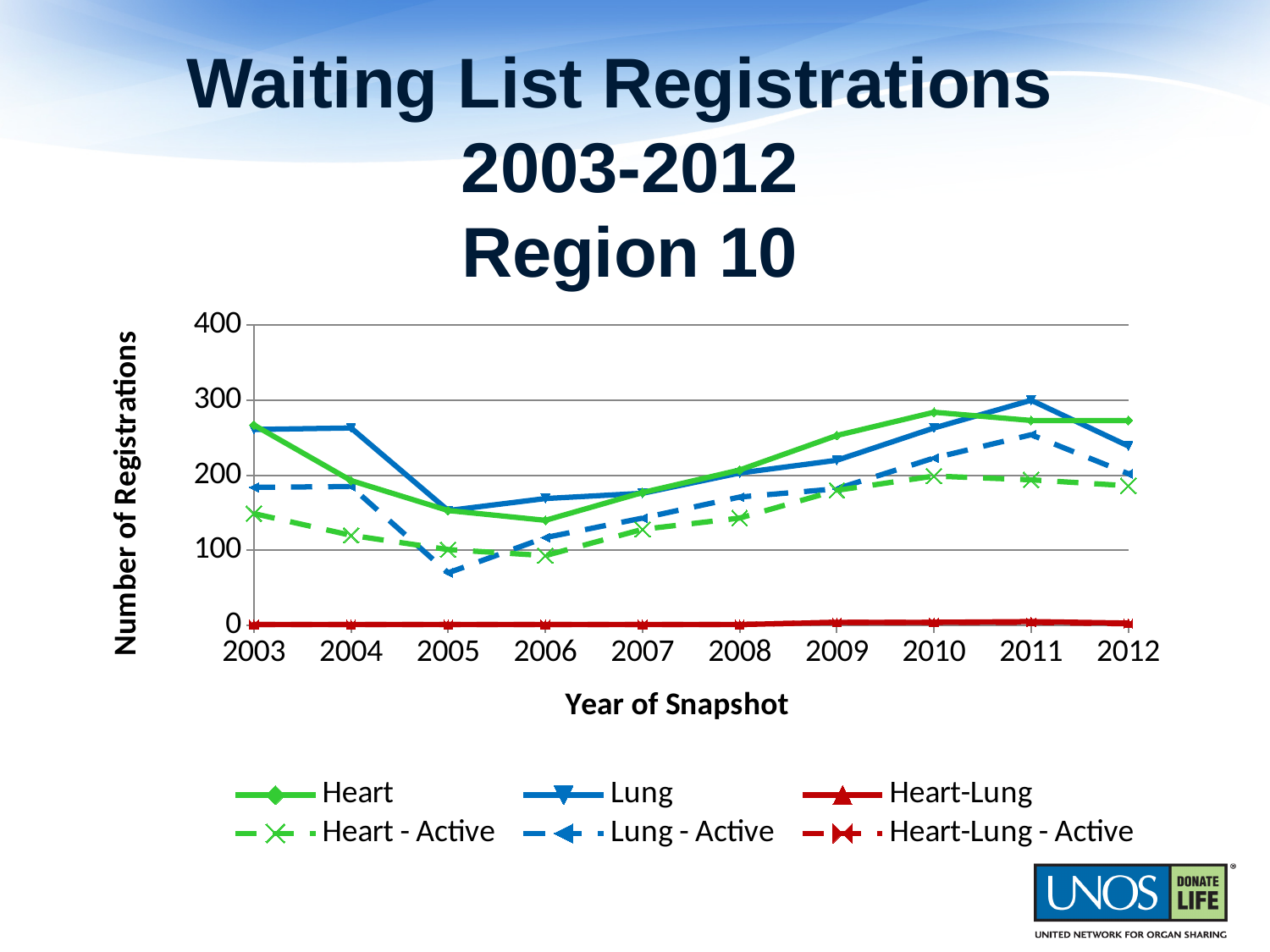
How many series does the legend list? 6 Is the value for Heart in 2010 greater or less than 200? greater What kind of chart is shown on the slide? Line chart How many years are plotted along the x axis? 10 In which year does the Lung - Active series reach its lowest value? 2005 In which year does the Lung series reach its highest value? 2011 Is the value for Lung - Active in 2005 greater or less than 100? less Does the Heart series rise or fall from 2003 to 2006? Fall What is the label of the y axis? Number of Registrations Is the value for Lung in 2011 greater or less than 200? greater In 2009, which is larger, the Heart value or the Lung value? Heart